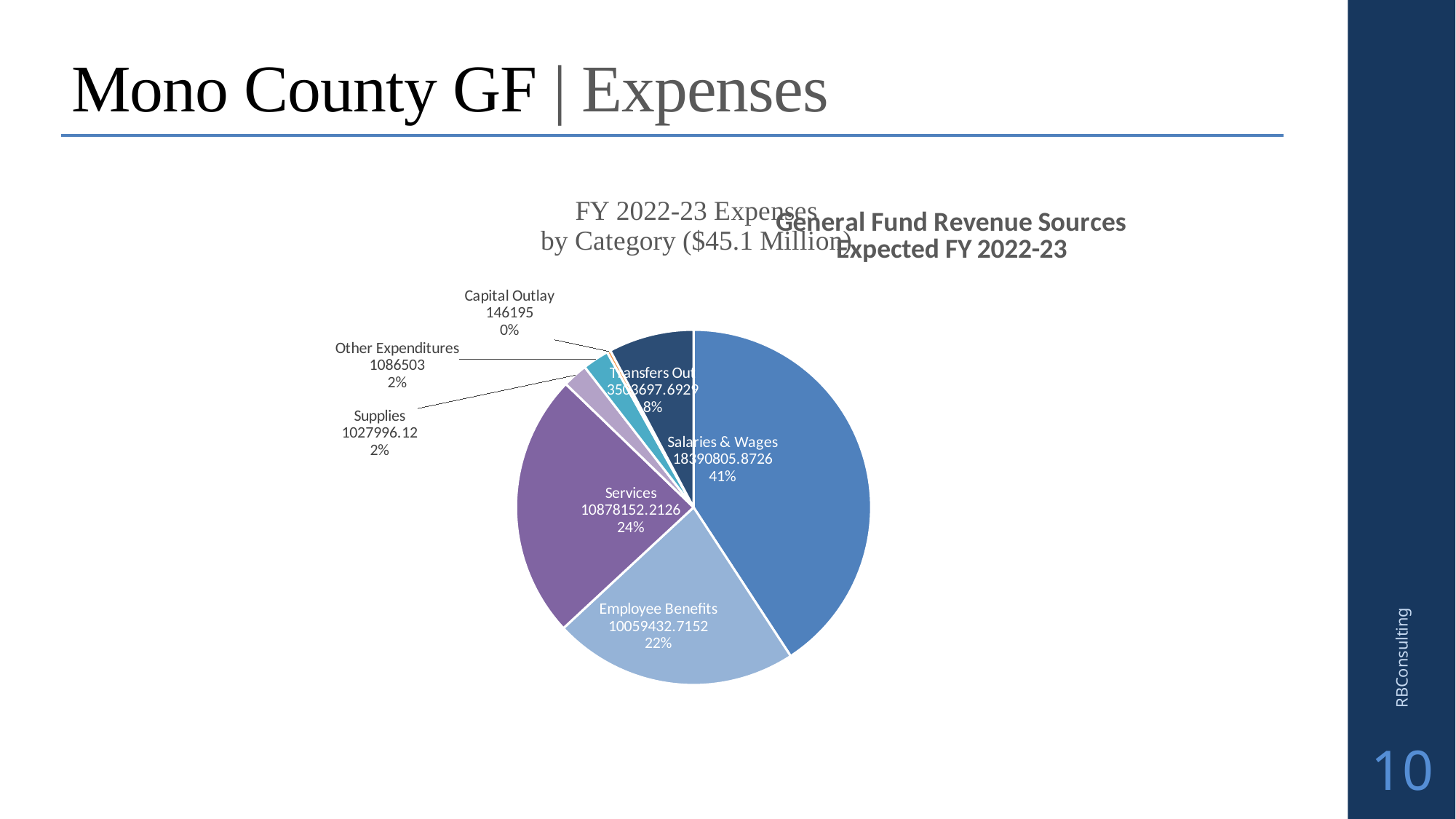
What type of chart is shown on the slide? Pie chart Which category has the largest slice of the pie? Salaries & Wages What is the value shown for Salaries & Wages in the pie chart? 18390805.8726 How many expense categories are shown in the pie chart? 7 Which category has the smallest slice of the pie? Capital Outlay What is the value shown for Employee Benefits? 10059432.7152 What is the value shown for Capital Outlay? 146195 What share of the pie does Transfers Out represent? 8% What percentage of the pie is Services? 24% What is the difference between the values for Other Expenditures and Supplies? 58506.88 Which is larger, Services or Employee Benefits? Services What share of the pie does Salaries & Wages represent? 41%